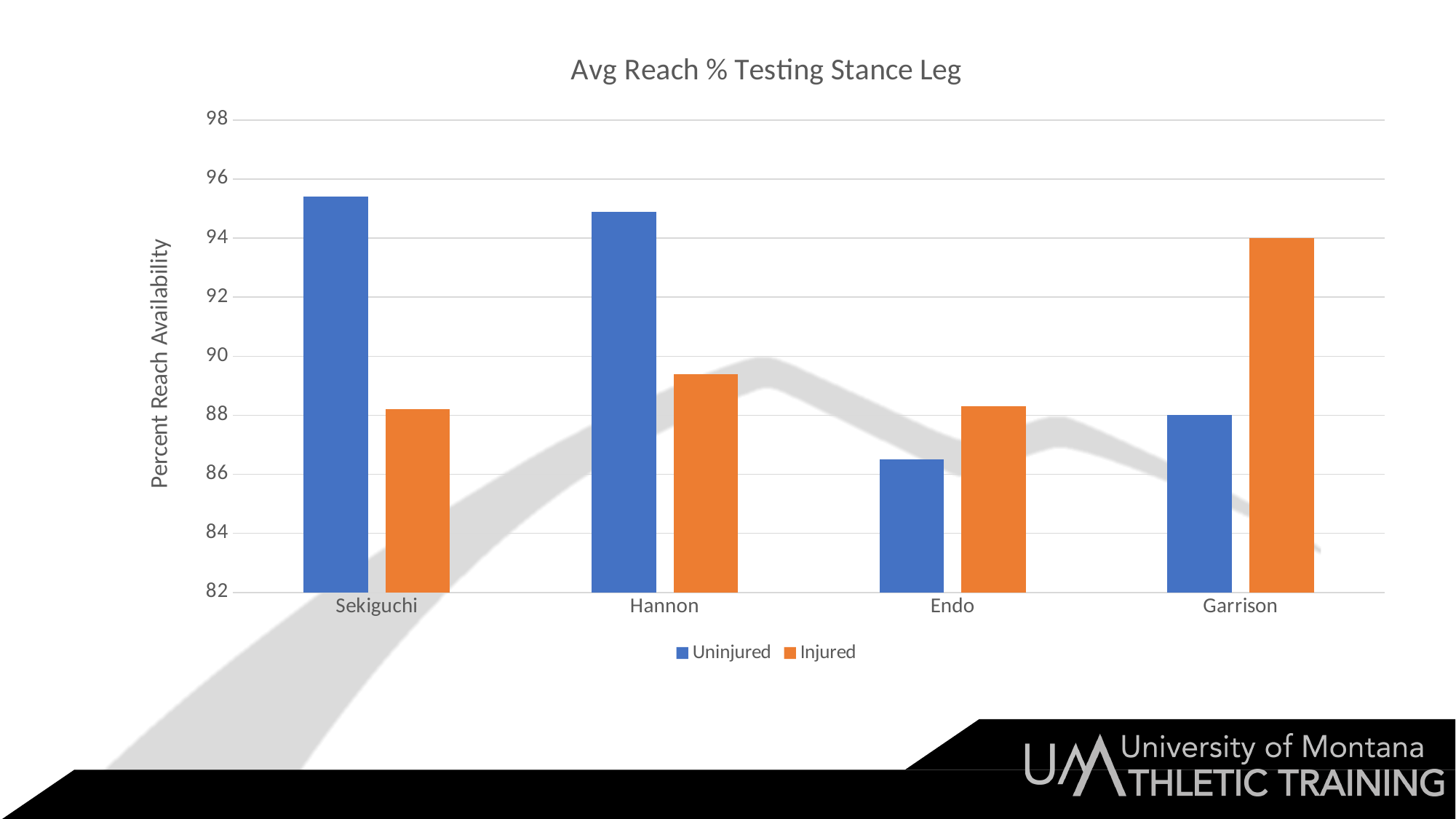
What kind of chart is shown on the slide? bar chart For Sekiguchi, which is larger, the Uninjured or the Injured value? Uninjured What is the title of the chart? Avg Reach % Testing Stance Leg How many series does the legend list? 2 Which subject has the lowest Uninjured value? Endo Is the Uninjured value for Endo greater or less than 88? less Is the Injured value for Hannon greater or less than 90? less Is the Uninjured value for Sekiguchi greater or less than 94? greater What is the label on the vertical axis? Percent Reach Availability For Endo, which is larger, the Uninjured or the Injured value? Injured How many categories (subjects) are shown on the x axis? 4 Which subject has the highest Injured value? Garrison